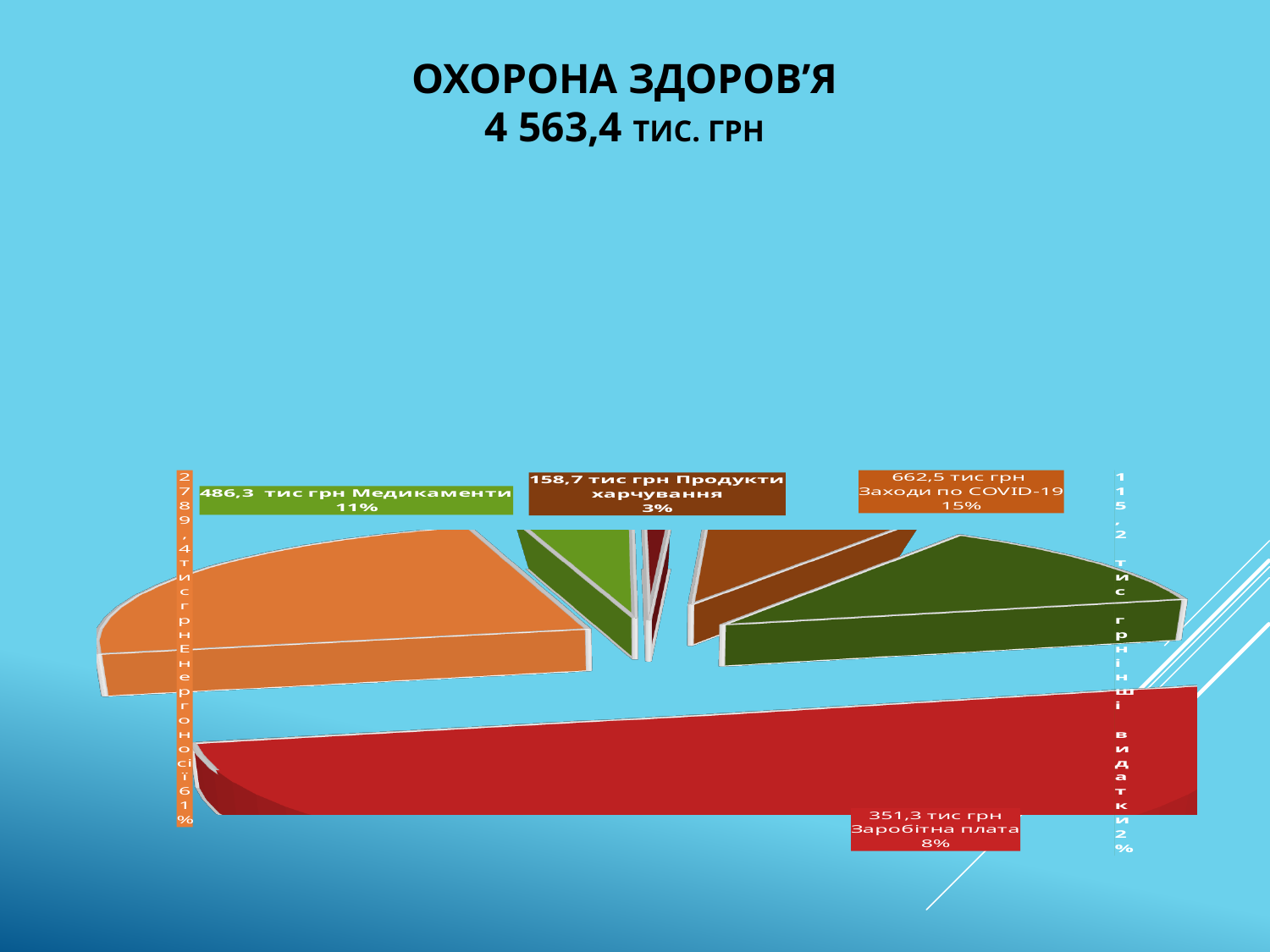
What is the value for Продукти харчування? 158,7 тис грн How many categories are shown in the pie chart? 6 What share of the pie does Заходи по COVID-19 represent? 15% What is the total amount shown in the slide title for ОХОРОНА ЗДОРОВ'Я? 4 563,4 тис. грн What is the value for Медикаменти? 486,3 тис грн What is the difference between the values for Заходи по COVID-19 and Медикаменти? 176,2 тис грн What share of the pie does Заробітна плата represent? 8% Which is larger, the value for Заходи по COVID-19 or the value for Заробітна плата? Заходи по COVID-19 What is the value for Енергоносії? 2789,4 тис грн Which category has the smallest share of the pie? Інші видатки Which category has the largest share of the pie? Енергоносії What kind of chart is shown on the slide? pie chart